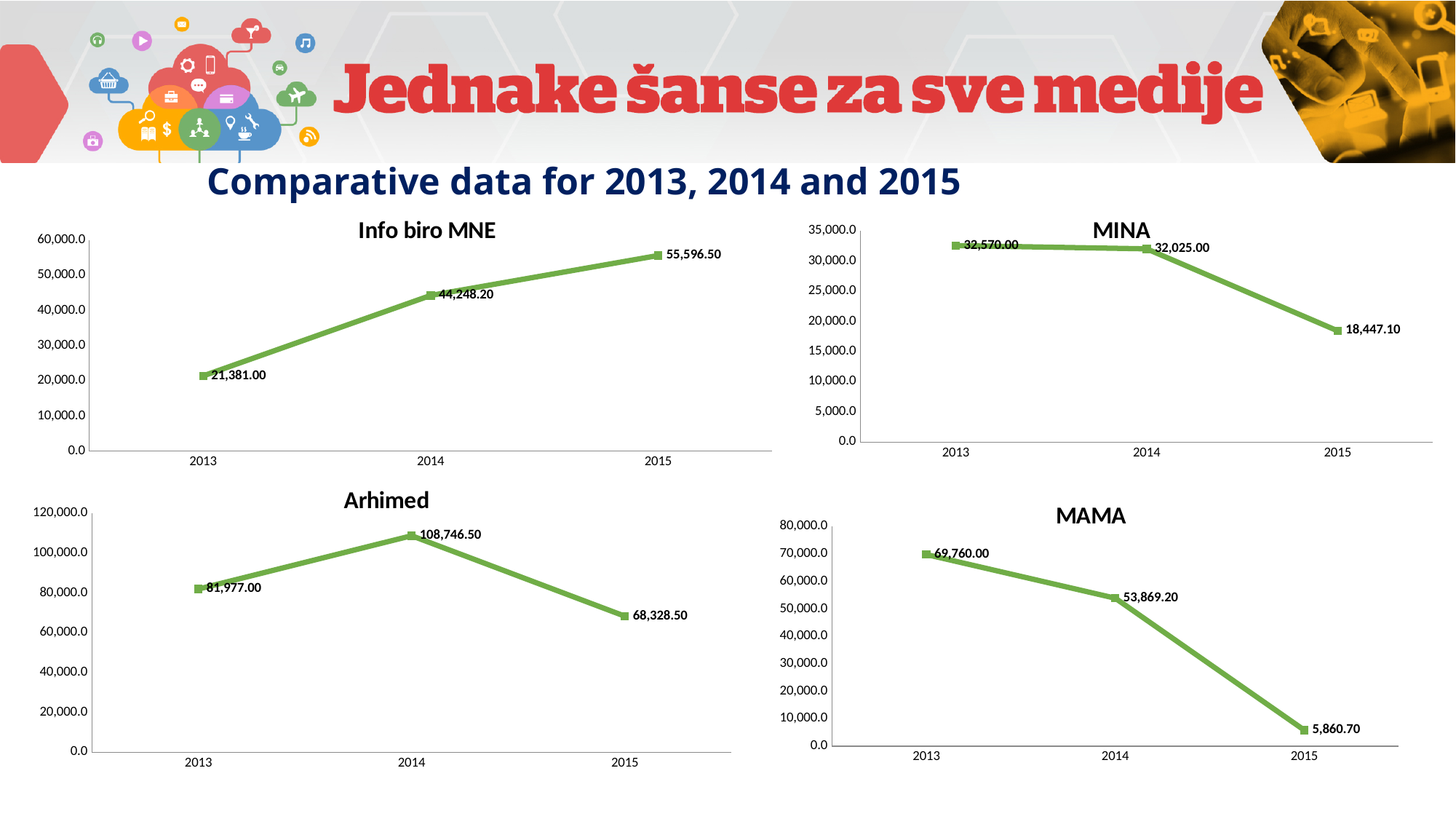
In the MAMA chart, what is the value for 2013? 69,760.00 In the MAMA chart, which year has the lowest value? 2015 In the Arhimed chart, what is the value for 2014? 108,746.50 How many data points are plotted in the MINA chart? 3 In the Info biro MNE chart, do the values rise or fall from 2013 to 2015? rise In the Info biro MNE chart, what is the difference between the 2015 and 2013 values? 34,215.50 In the Arhimed chart, which year has the highest value? 2014 In the MINA chart, which is larger, the value for 2013 or the value for 2015? 2013 In the Info biro MNE chart, what is the value for 2015? 55,596.50 What kind of chart is the Arhimed chart? line chart In the MINA chart, what is the value for 2015? 18,447.10 In the MAMA chart, what is the difference between the 2013 and 2015 values? 63,899.30